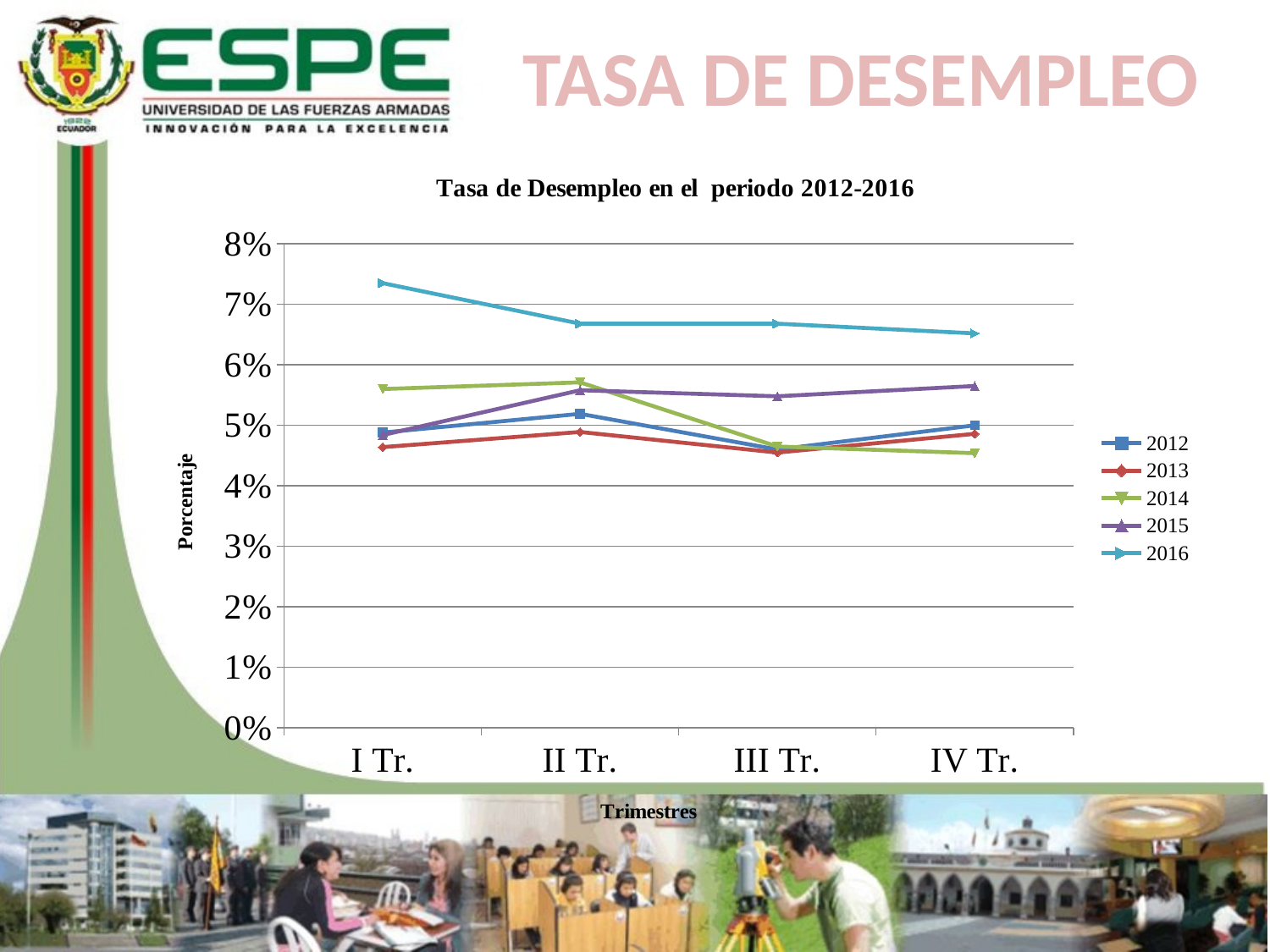
Which year has the highest unemployment rate in I Tr.? 2016 Does the 2016 line rise or fall from I Tr. to IV Tr.? fall Which year has the lowest unemployment rate in IV Tr.? 2014 In II Tr., which is larger, the value for 2016 or the value for 2013? 2016 How many series does the legend list? 5 What kind of chart is shown on the slide? line chart What is the title of the chart? Tasa de Desempleo en el periodo 2012-2016 Is the value for 2014 in IV Tr. greater or less than 5%? less Is the value for 2015 in II Tr. greater or less than 5%? greater What is the label of the vertical axis? Porcentaje How many quarters (trimestres) are shown on the x axis? 4 Is the value for 2016 in I Tr. greater or less than 7%? greater